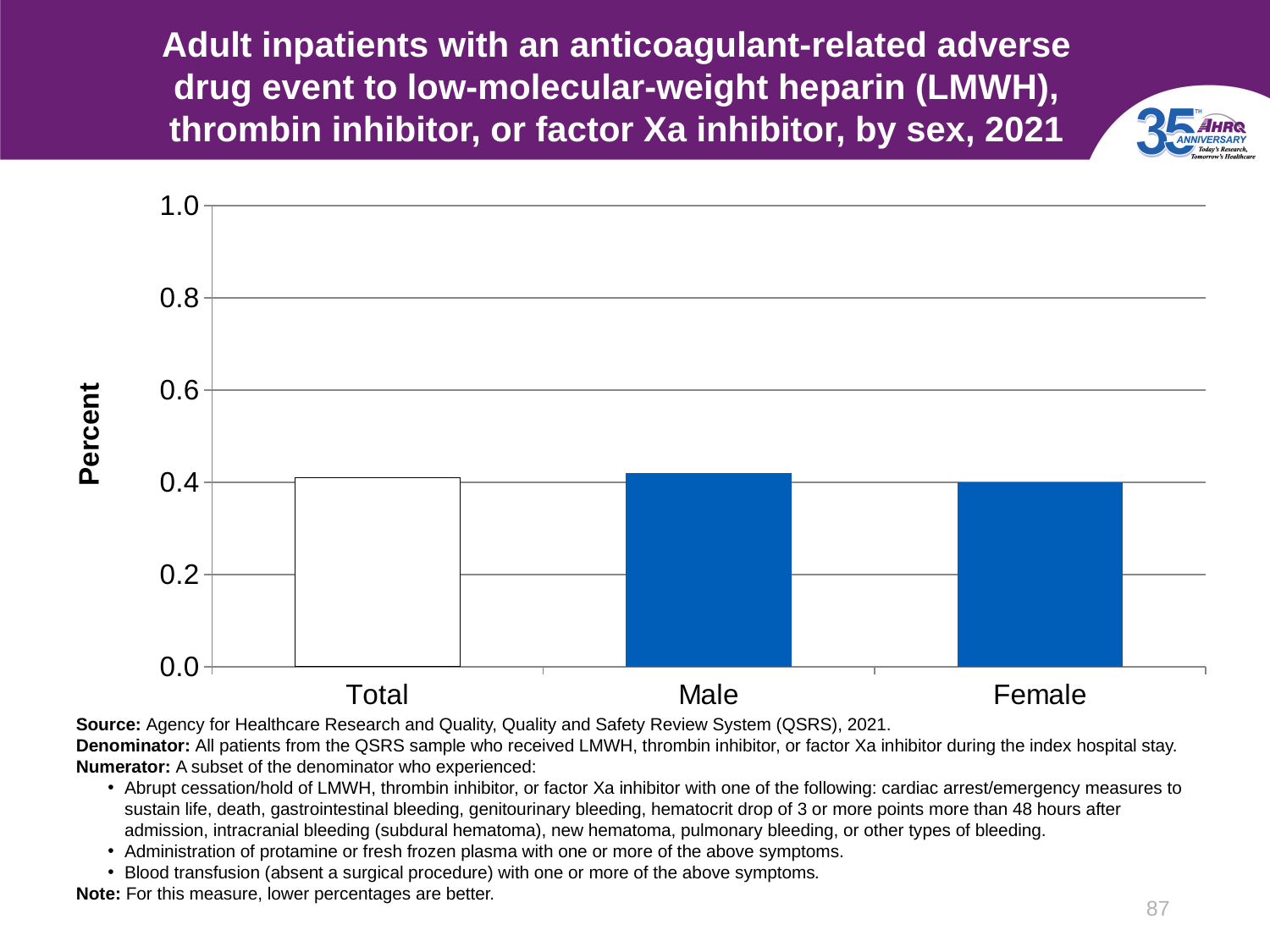
How many categories are shown on the x axis of the chart? 3 What is the highest value shown on the y axis of the chart? 1.0 Is the value for Male greater or less than 0.8? less Is the value for Total greater or less than 0.6? less Is the value for Male greater or less than 0.6? less What is the label on the y axis of the chart? Percent What kind of chart is shown on the slide? bar chart